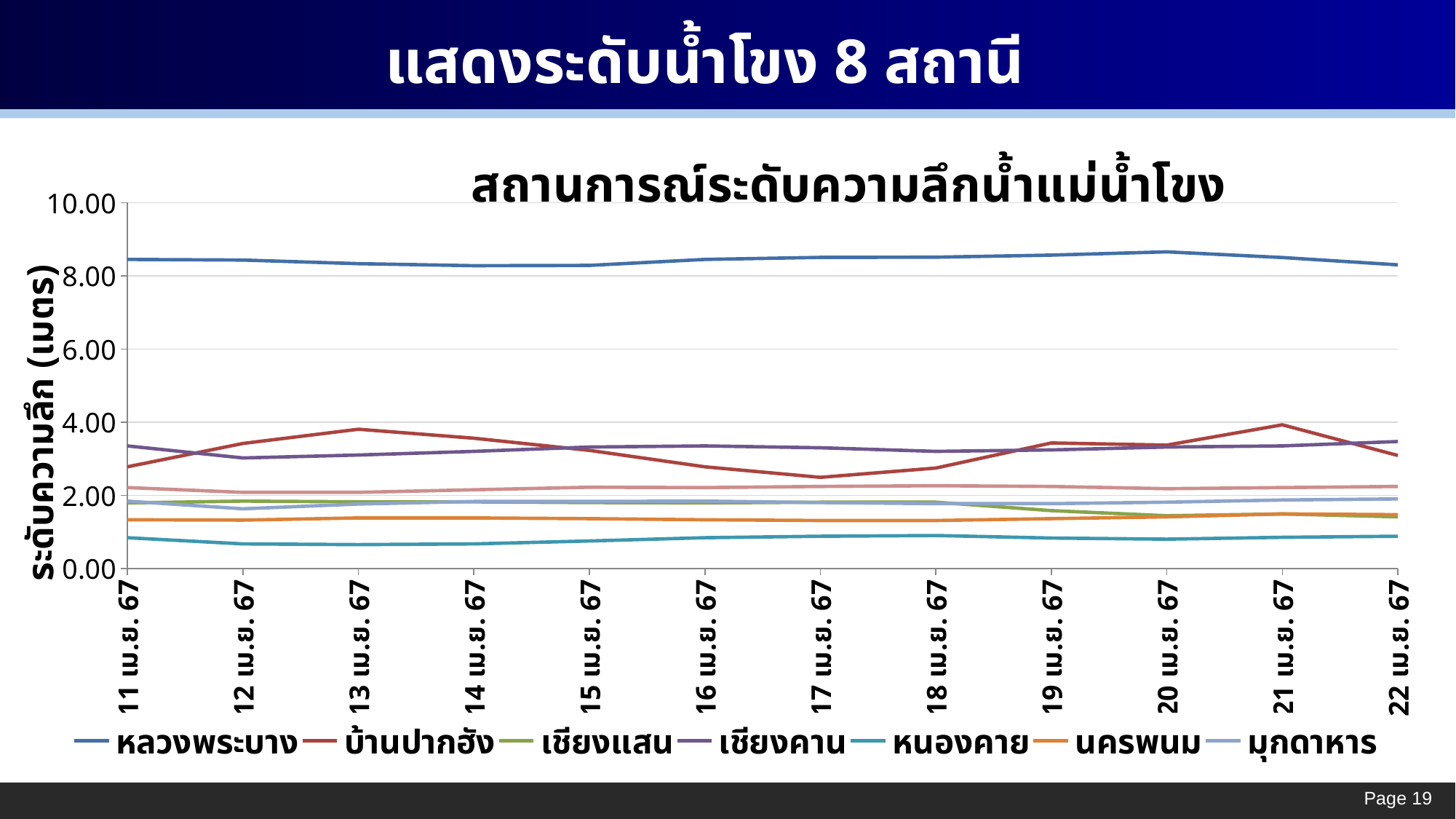
What kind of chart is shown on the slide? line chart Is the value for บ้านปากฮัง on 21 เม.ย. 67 greater or less than 3.00? greater How many series does the legend list? 7 Is the value for หนองคาย on 11 เม.ย. 67 greater or less than 2.00? less How many dates are plotted along the x axis? 12 Is the value for หลวงพระบาง on 11 เม.ย. 67 greater or less than 8.00? greater Which station has the lowest water level across the whole period? หนองคาย On 17 เม.ย. 67, which is higher: บ้านปากฮัง or เชียงคาน? เชียงคาน On 13 เม.ย. 67, which is higher: บ้านปากฮัง or เชียงคาน? บ้านปากฮัง What is the label on the y axis of the chart? ระดับความลึก (เมตร) Which station has the highest water level across the whole period? หลวงพระบาง Does the line for บ้านปากฮัง rise or fall from 11 เม.ย. 67 to 13 เม.ย. 67? rise